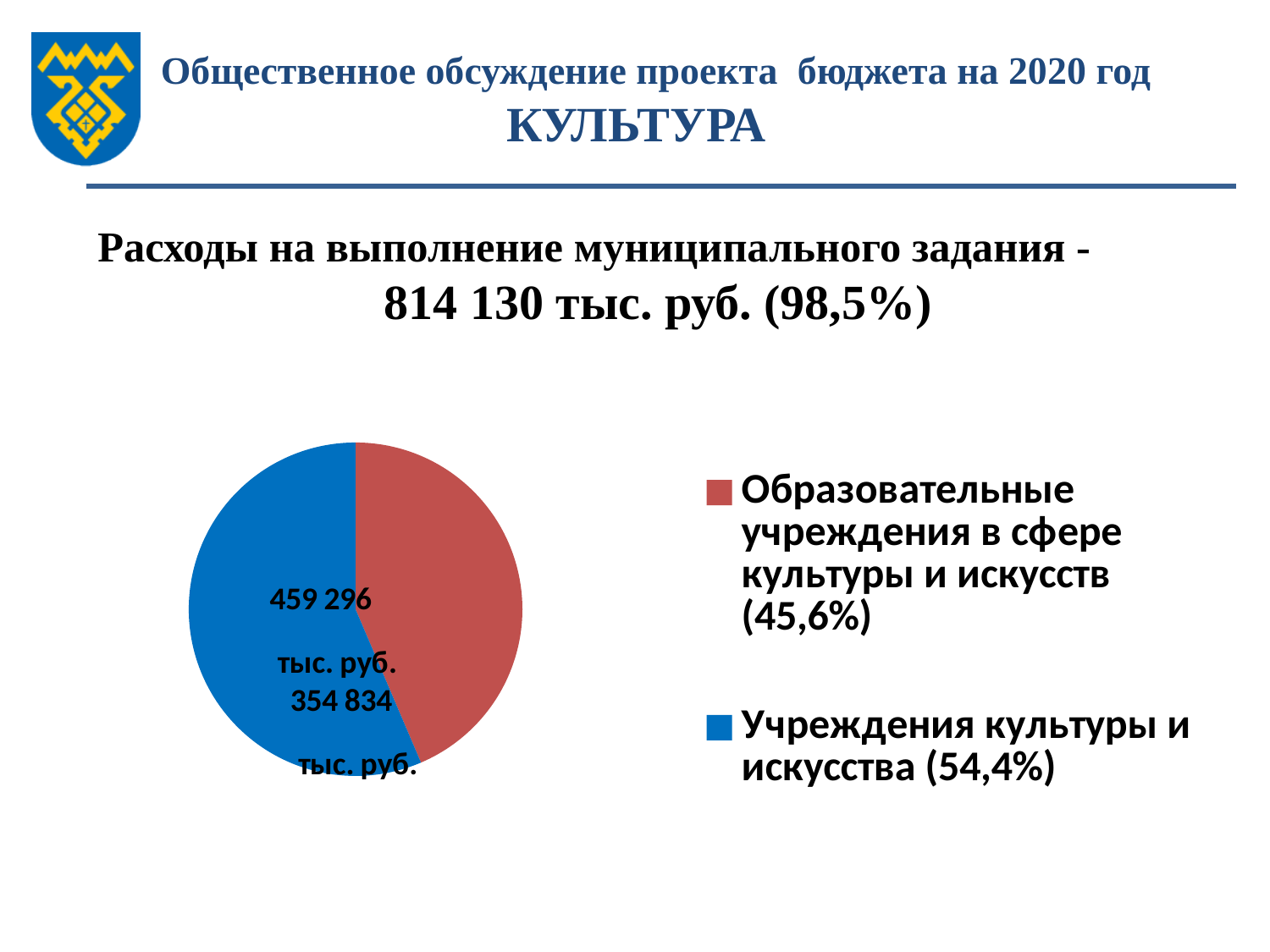
Which slice of the pie chart is the largest? Учреждения культуры и искусства What colour is the slice for 'Образовательные учреждения в сфере культуры и искусств'? red What value is labelled for the red slice ('Образовательные учреждения в сфере культуры и искусств')? 354 834 тыс. руб. How many entries does the legend of the pie chart list? 2 What kind of chart is shown on the slide? pie chart What is the difference between the two values labelled on the pie chart, 459 296 and 354 834 тыс. руб.? 104 462 тыс. руб. Which is larger: the slice for 'Учреждения культуры и искусства' or the slice for 'Образовательные учреждения в сфере культуры и искусств'? Учреждения культуры и искусства What value is labelled on the blue slice ('Учреждения культуры и искусства')? 459 296 тыс. руб. Which slice of the pie chart is the smallest? Образовательные учреждения в сфере культуры и искусств What share of the pie does 'Образовательные учреждения в сфере культуры и искусств' have? 45,6% How many slices does the pie chart have? 2 What share of the pie does 'Учреждения культуры и искусства' have? 54,4%